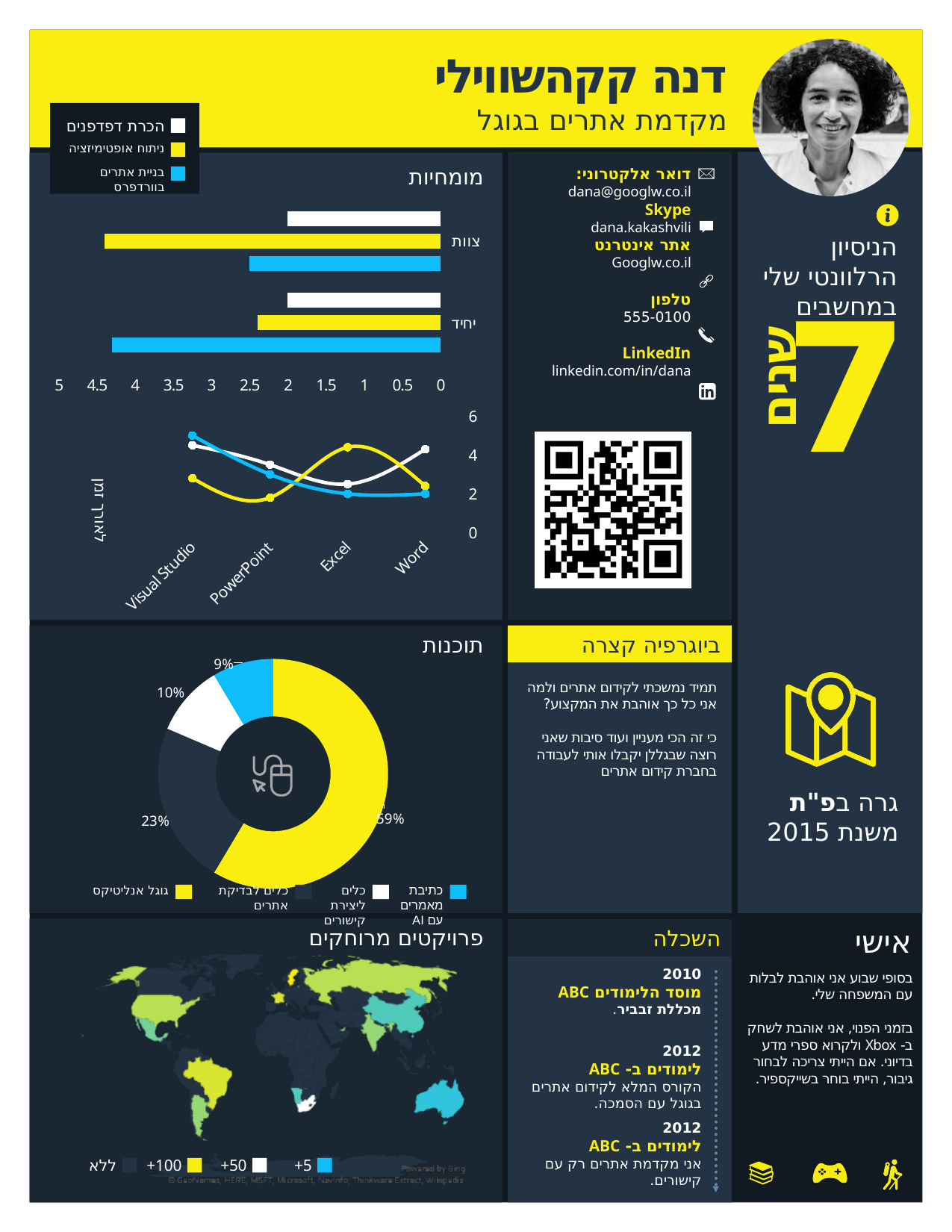
In the donut chart titled תוכנות, which category has the smallest share? כתיבת מאמרים עם AI In the bar chart titled מומחיות, is the value of ניתוח אופטימיזציה for צוות greater or less than 4? greater In the donut chart titled תוכנות, which category has the largest share? גוגל אנליטיקס In the bar chart titled מומחיות, which series has the longest bar for צוות? ניתוח אופטימיזציה In the bar chart titled מומחיות, which series has the longest bar for יחיד? בניית אתרים בוורדפרס In the donut chart titled תוכנות, what percentage is shown for כלים לבדיקת אתרים? 23% In the bar chart titled מומחיות, how many series does the legend list? 3 In the donut chart titled תוכנות, what is the difference in percentage points between גוגל אנליטיקס and כלים לבדיקת אתרים? 36 How many slices does the donut chart titled תוכנות have? 4 In the donut chart titled תוכנות, what percentage is shown for גוגל אנליטיקס? 59% How many categories are shown on the x axis of the line chart in the left panel (Visual Studio, PowerPoint, Excel, Word)? 4 What kind of chart is the chart titled פרויקטים מרוחקים? map chart